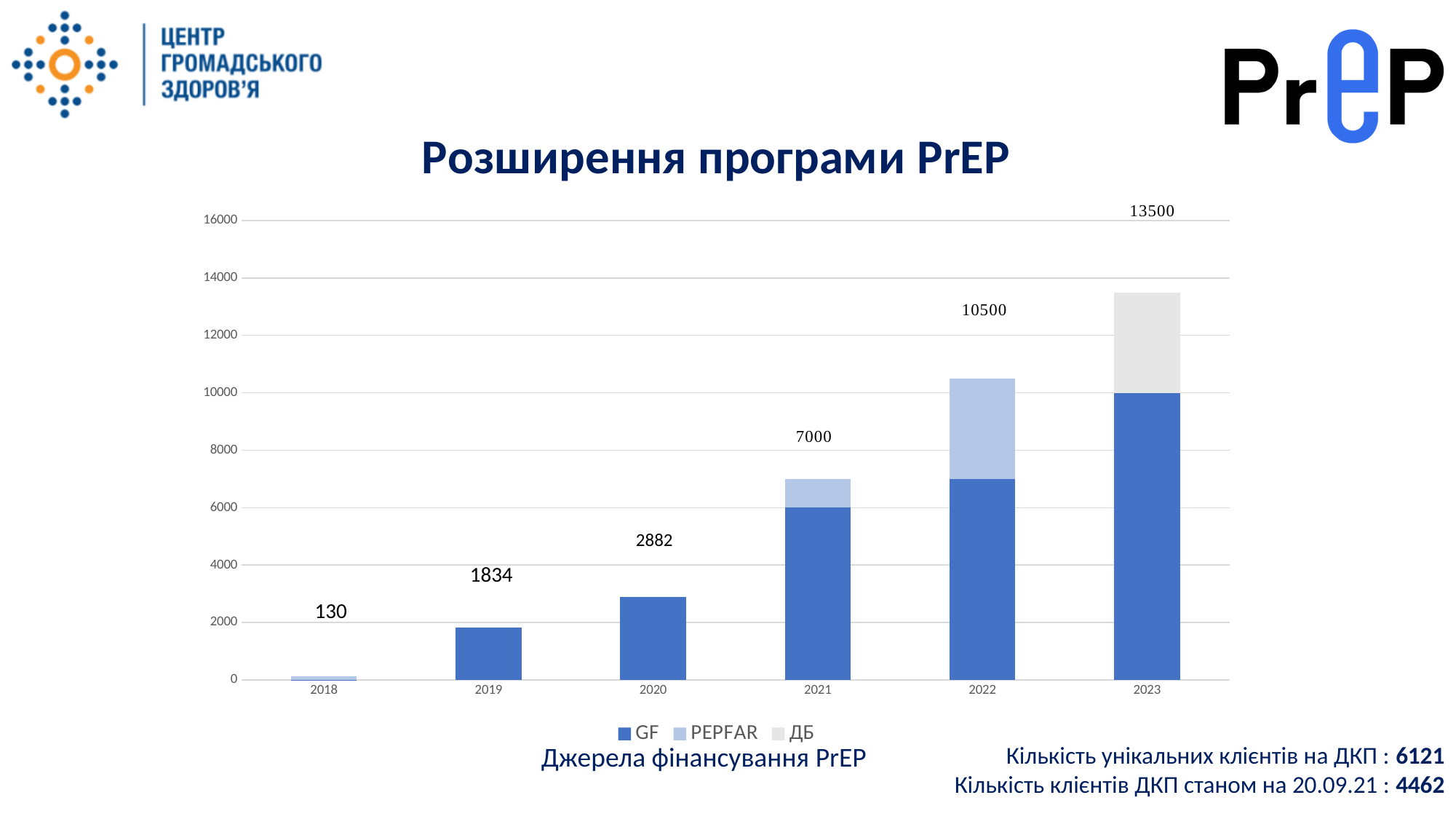
Which year has the highest total? 2023 Is the GF value for 2023 greater or less than 8000? greater Which year has a larger total, 2019 or 2021? 2021 Do the totals rise or fall from 2018 to 2023? rise Which year has the lowest total? 2018 What is the difference between the totals for 2021 and 2020? 4118 What is the total value shown for 2018? 130 What is the total value shown for 2020? 2882 What is the total value shown for 2023? 13500 What is the difference between the totals for 2023 and 2022? 3000 How many series does the legend list? 3 How many years are shown on the x axis? 6